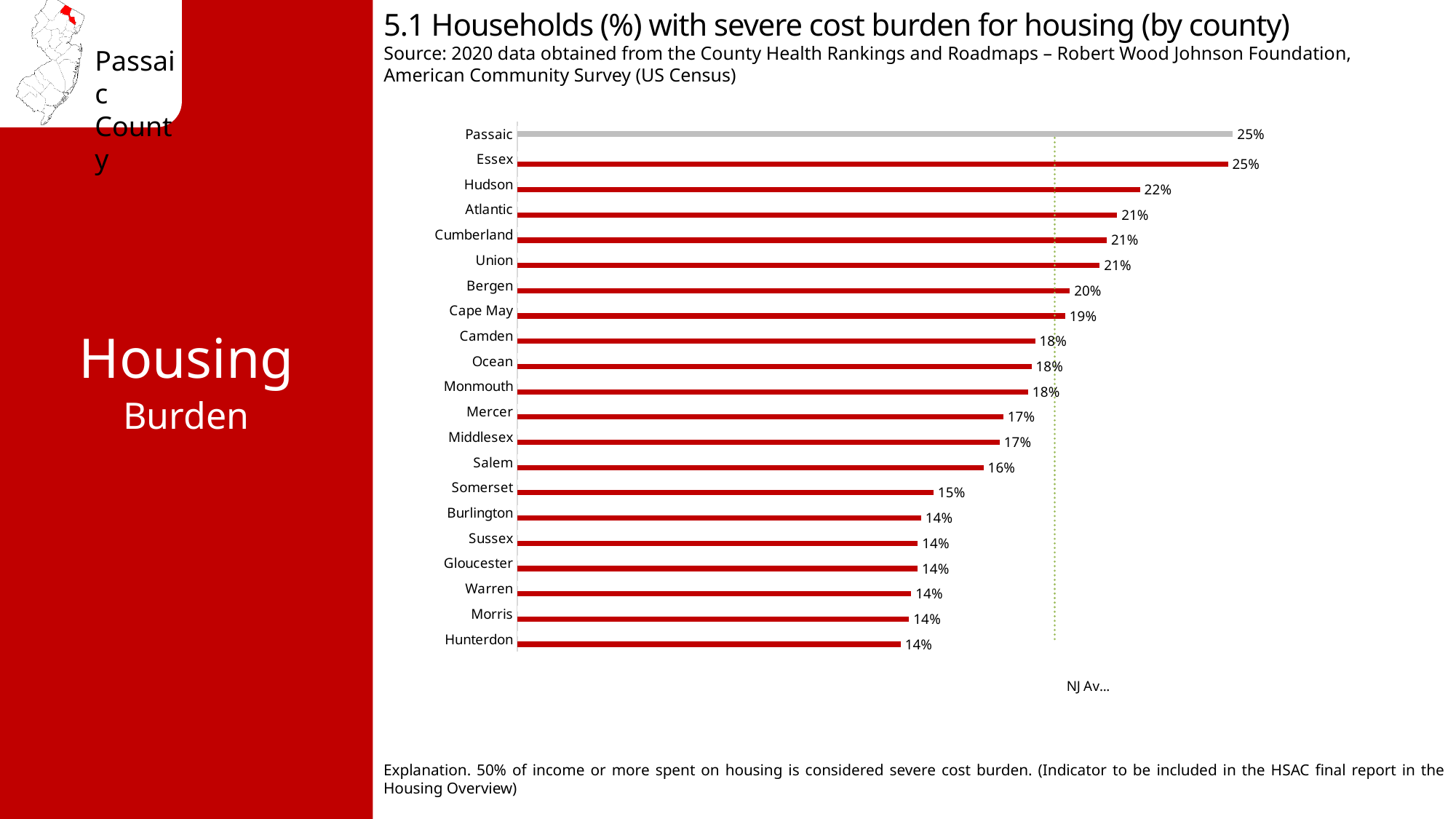
What is the value for Passaic? 25% Which has a larger value, Hudson or Bergen? Hudson Which county's bar is coloured grey instead of red? Passaic What is the value for Hunterdon? 14% What is the difference between the values for Passaic and Hudson? 3% What is the value for Cape May? 19% How many counties are shown in the chart? 21 What is the value for Hudson? 22% What kind of chart is shown on the slide? Bar chart What is the value for Somerset? 15% What is the difference between the values for Bergen and Salem? 4% Which has a larger value, Somerset or Mercer? Mercer